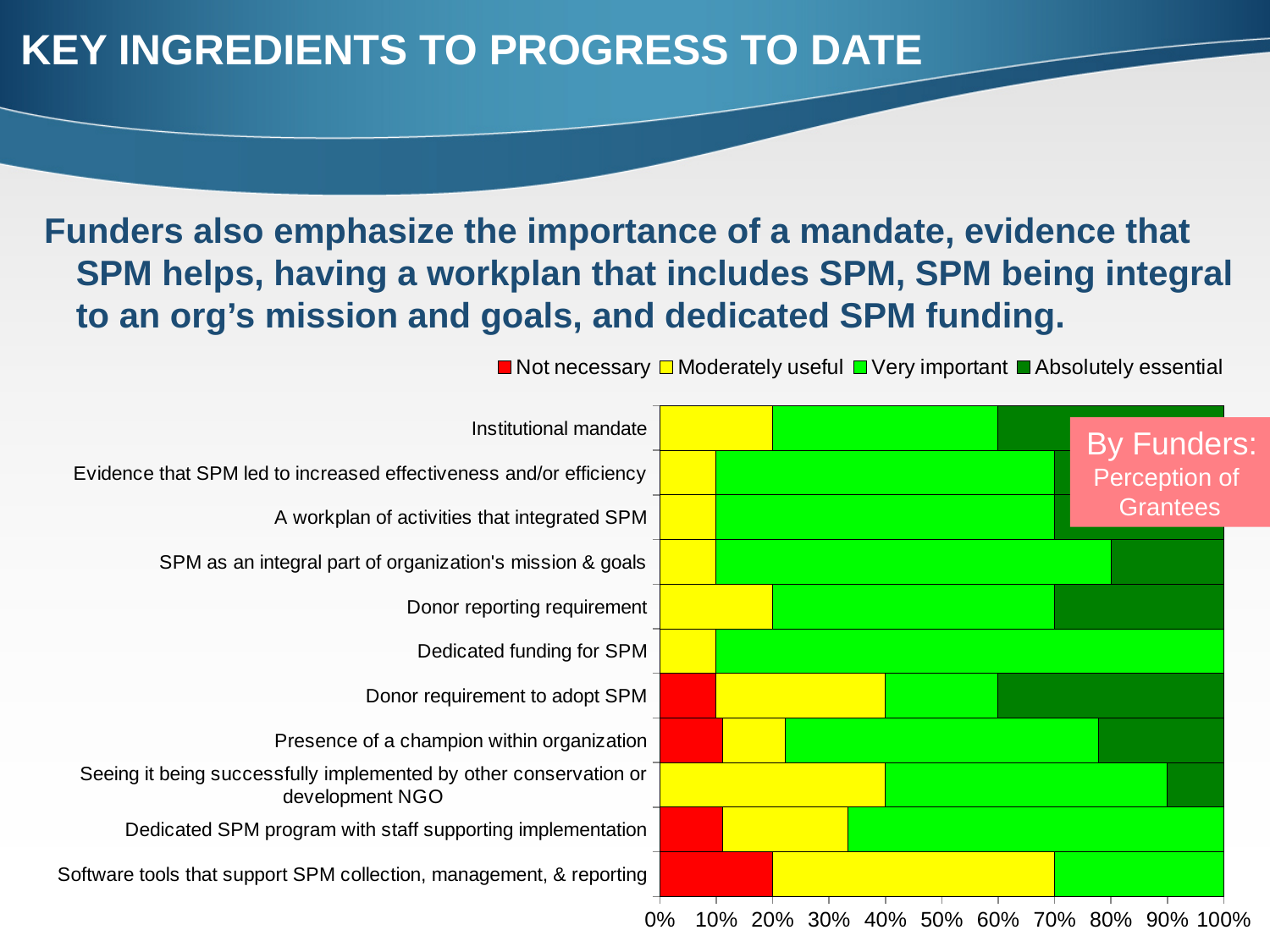
What colour represents the 'Not necessary' series? Red What is the 'Moderately useful' share for 'Seeing it being successfully implemented by other conservation or development NGO'? 40% What are the four legend entries of the chart? Not necessary, Moderately useful, Very important, Absolutely essential Which has a larger 'Not necessary' share: 'Software tools that support SPM collection, management, & reporting' or 'Donor requirement to adopt SPM'? Software tools that support SPM collection, management, & reporting Which category has the largest 'Not necessary' segment? Software tools that support SPM collection, management, & reporting How many categories have a 'Not necessary' (red) segment? 4 How many categories (ingredients) are plotted on the chart? 11 Which category has the largest 'Moderately useful' segment? Software tools that support SPM collection, management, & reporting Is the 'Very important' share for 'Dedicated funding for SPM' greater or less than 80%? greater What kind of chart is shown on the slide? Stacked bar chart How many series does the legend list? 4 What is the 'Not necessary' share for 'Software tools that support SPM collection, management, & reporting'? 20%